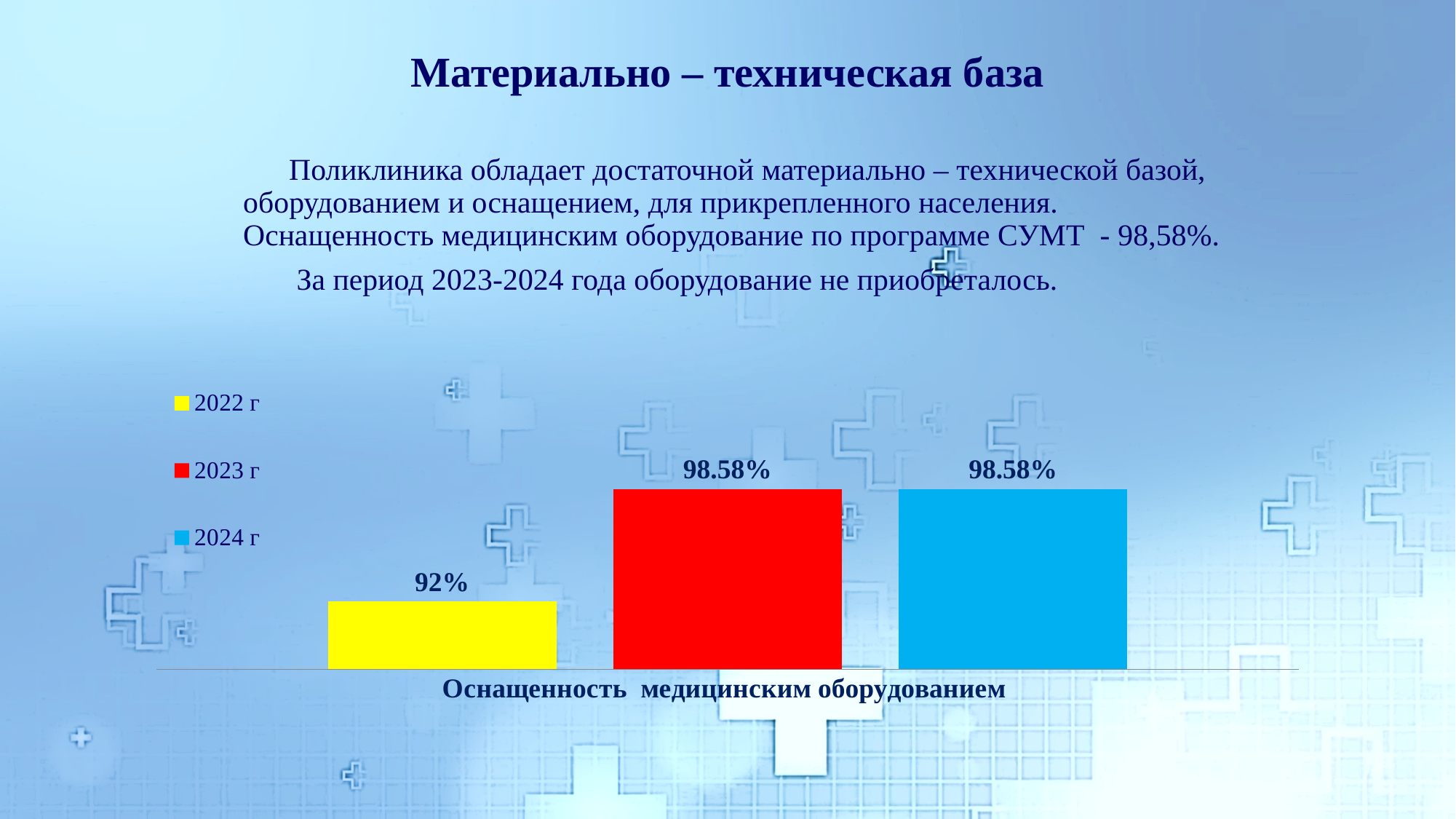
How many series does the legend list? 3 Which year has the lowest value in the chart? 2022 г What is the value for 2024 г in the chart? 98.58% What colour is the bar for 2024 г? Blue Does the value rise or fall from 2022 г to 2023 г? Rise What is the value for 2022 г in the chart? 92% What kind of chart is shown on the slide? Bar chart How many categories are shown on the x axis of the chart? 1 What is the value for 2023 г in the chart? 98.58% What is the difference between the values for 2023 г and 2022 г? 6.58% Are the values for 2023 г and 2024 г equal? Yes Which is larger, the value for 2022 г or the value for 2023 г? 2023 г